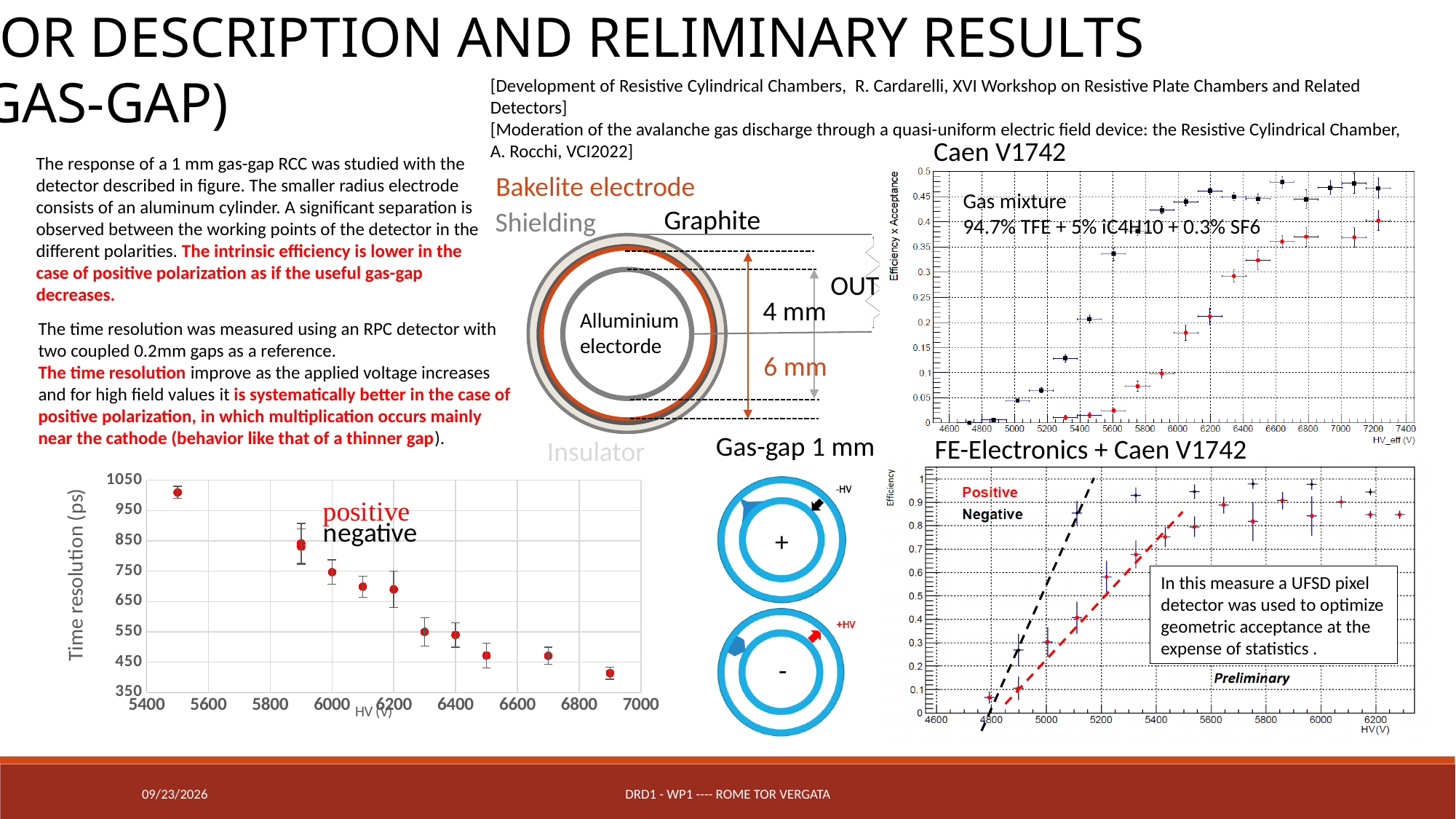
What kind of chart is the bottom-left chart of time resolution versus HV? scatter plot What is the x-axis label of the 'Caen V1742' chart? HV_eff (V) In the 'Caen V1742' chart, does Efficiency x Acceptance generally rise or fall as HV_eff increases? rise In the bottom-left time resolution chart, does the time resolution rise or fall as HV increases? fall In the 'Caen V1742' chart, is the highest Efficiency x Acceptance value greater or less than 0.4? greater In the 'FE-Electronics + Caen V1742' chart, which series has the higher efficiency at 5100 V, Positive or Negative? Negative In the bottom-left time resolution chart, is the time resolution at 5500 V greater or less than 950 ps? greater What is the y-axis label of the bottom-left time resolution chart? Time resolution (ps) In the 'FE-Electronics + Caen V1742' chart, is the Negative efficiency at 4800 V greater or less than 0.2? less How many series does the legend of the 'FE-Electronics + Caen V1742' chart list? 2